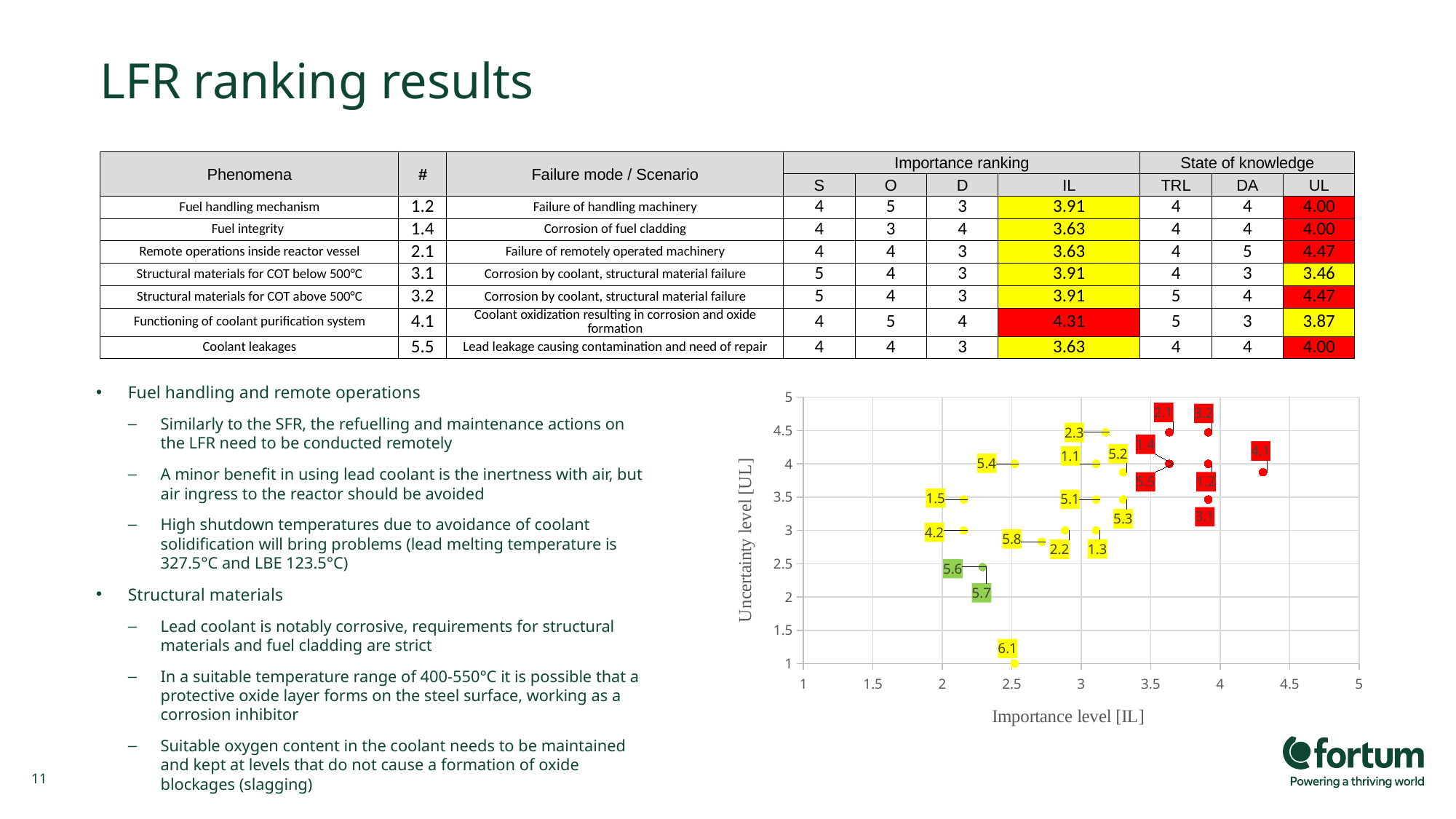
Is the importance level of point 4.1 greater or less than 4? greater Which labelled point has the highest importance level in the scatter chart? 4.1 What kind of chart is shown on the slide? scatter chart Is the uncertainty level of point 6.1 greater or less than 1.5? less Is the importance level of point 1.5 greater or less than 2.5? less Which point has a higher uncertainty level, 2.3 or 6.1? 2.3 Which point has a higher importance level, 4.1 or 5.7? 4.1 What is the title of the y axis of the scatter chart? Uncertainty level [UL] Which labelled point has the lowest uncertainty level in the scatter chart? 6.1 What is the title of the x axis of the scatter chart? Importance level [IL]